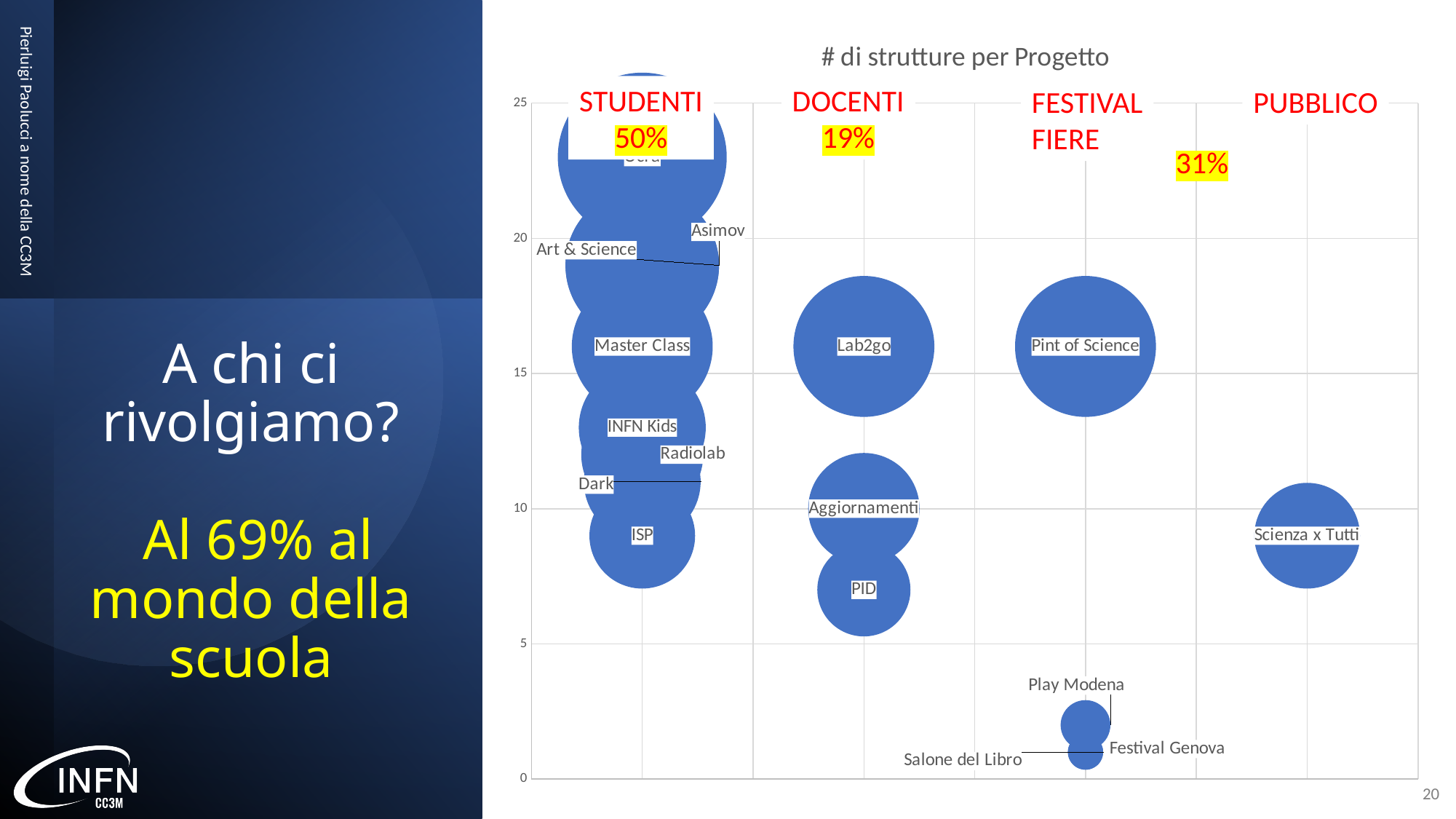
What percentage is shown for the STUDENTI group on the chart? 50% Is the value for Scienza x Tutti greater or less than 10? less Which has the higher value, Lab2go or PID? Lab2go What kind of chart is shown on the slide? bubble chart Is the value for PID greater or less than 5? greater Which has the higher value, Pint of Science or Scienza x Tutti? Pint of Science Is the value for Pint of Science greater or less than 15? greater What is the title of the chart? # di strutture per Progetto